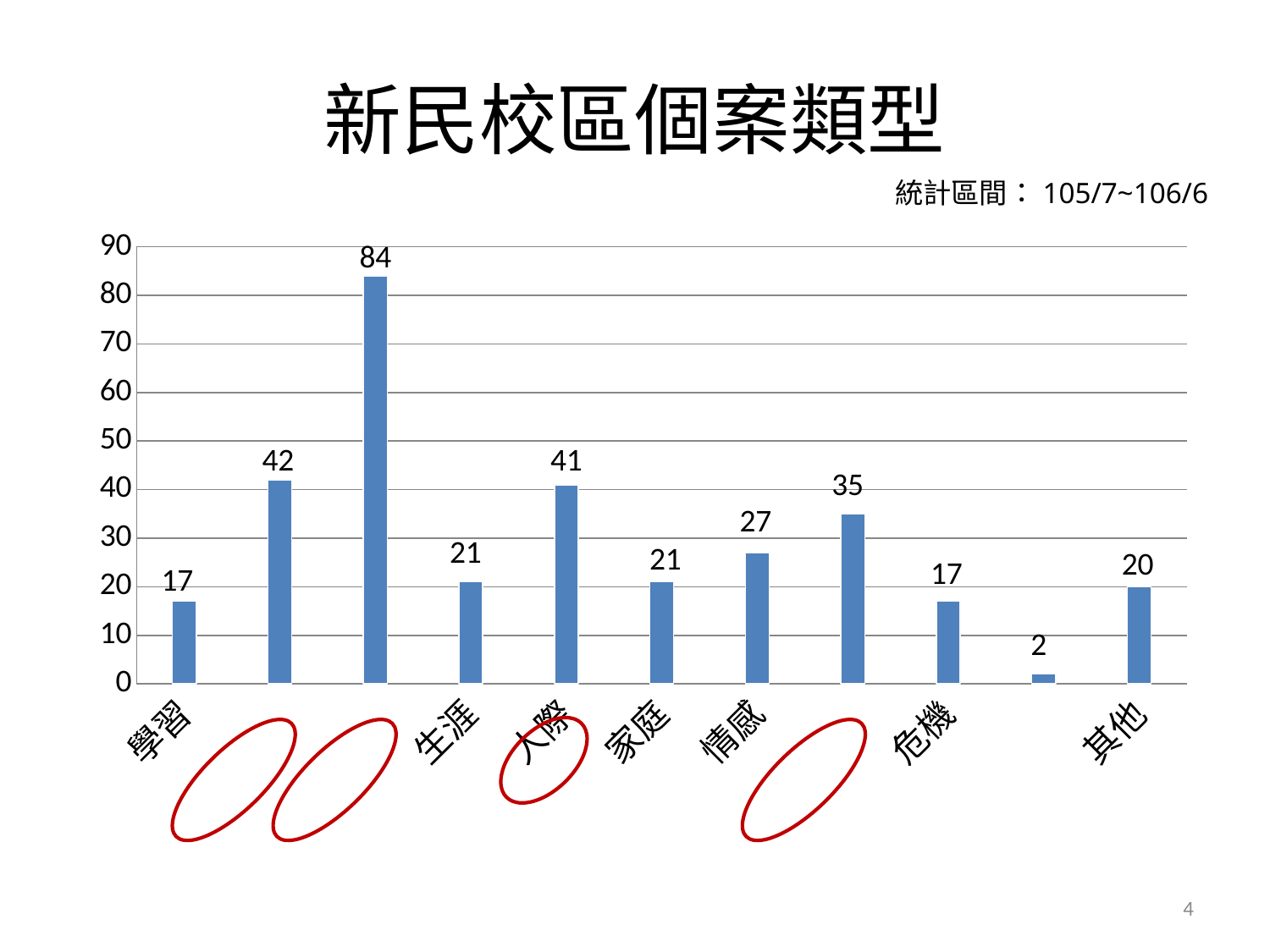
What is the difference between the values for 人際 and 家庭? 20 Which has a larger value, 情感 or 生涯? 情感 What is the title of the chart? 新民校區個案類型 How many bars are plotted in the chart? 11 What is the value for 危機? 17 What is the value for 學習? 17 What type of chart is shown on the slide? bar chart What is the value of the tallest bar in the chart? 84 What is the value for 人際? 41 What is the value of the shortest bar in the chart? 2 What is the value for 情感? 27 What is the value for 其他? 20